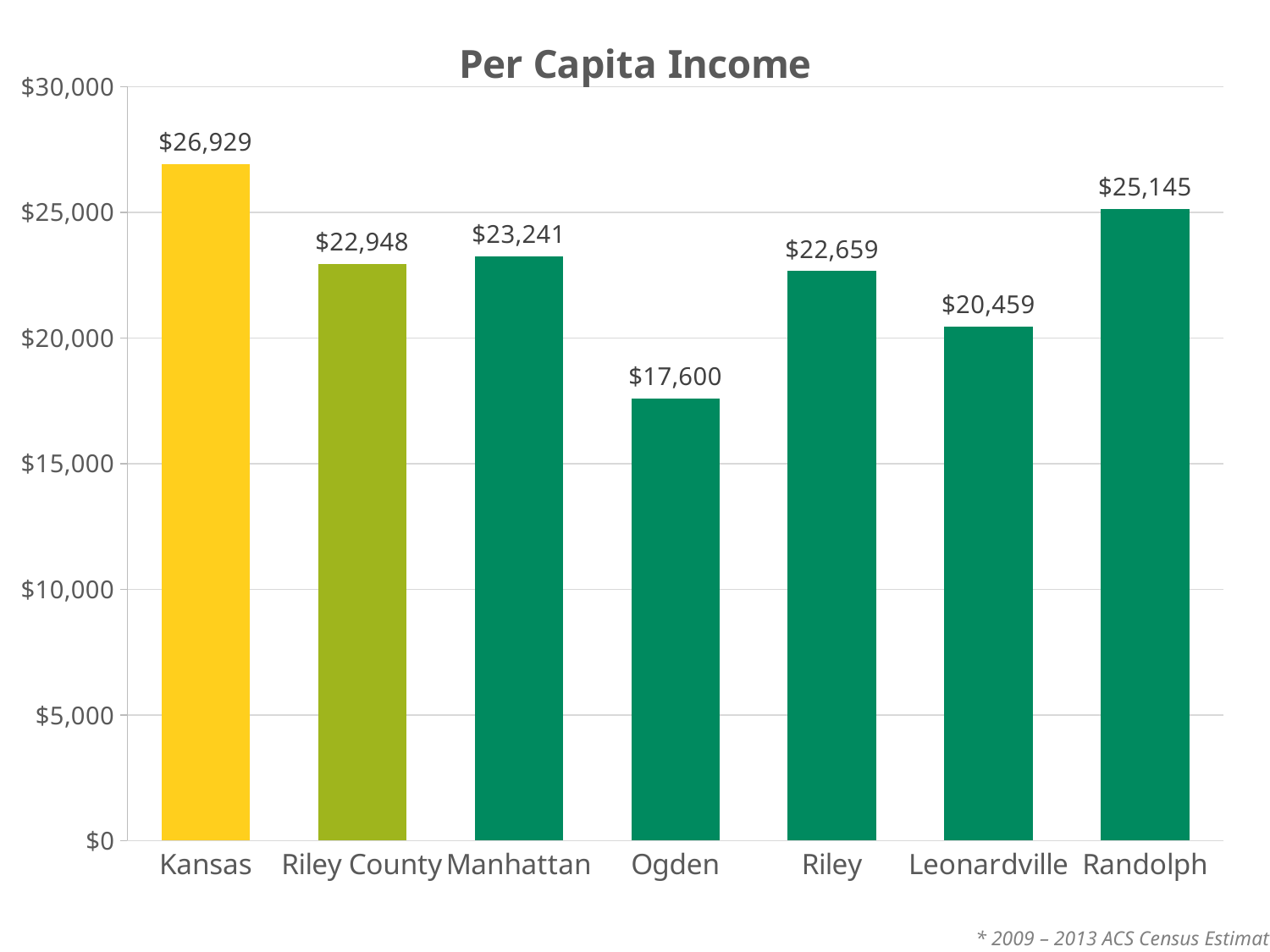
Which has a higher per capita income, Manhattan or Leonardville? Manhattan Which category has the lowest per capita income? Ogden What is the title of the chart? Per Capita Income What is the per capita income for Randolph? $25,145 What is the difference between the per capita income of Kansas and Riley County? $3,981 How many categories are shown in the chart? 7 What kind of chart is shown on the slide? Bar chart What is the per capita income for Kansas? $26,929 What is the per capita income for Leonardville? $20,459 Which category has the highest per capita income? Kansas What is the difference between the per capita income of Randolph and Ogden? $7,545 What is the per capita income for Ogden? $17,600